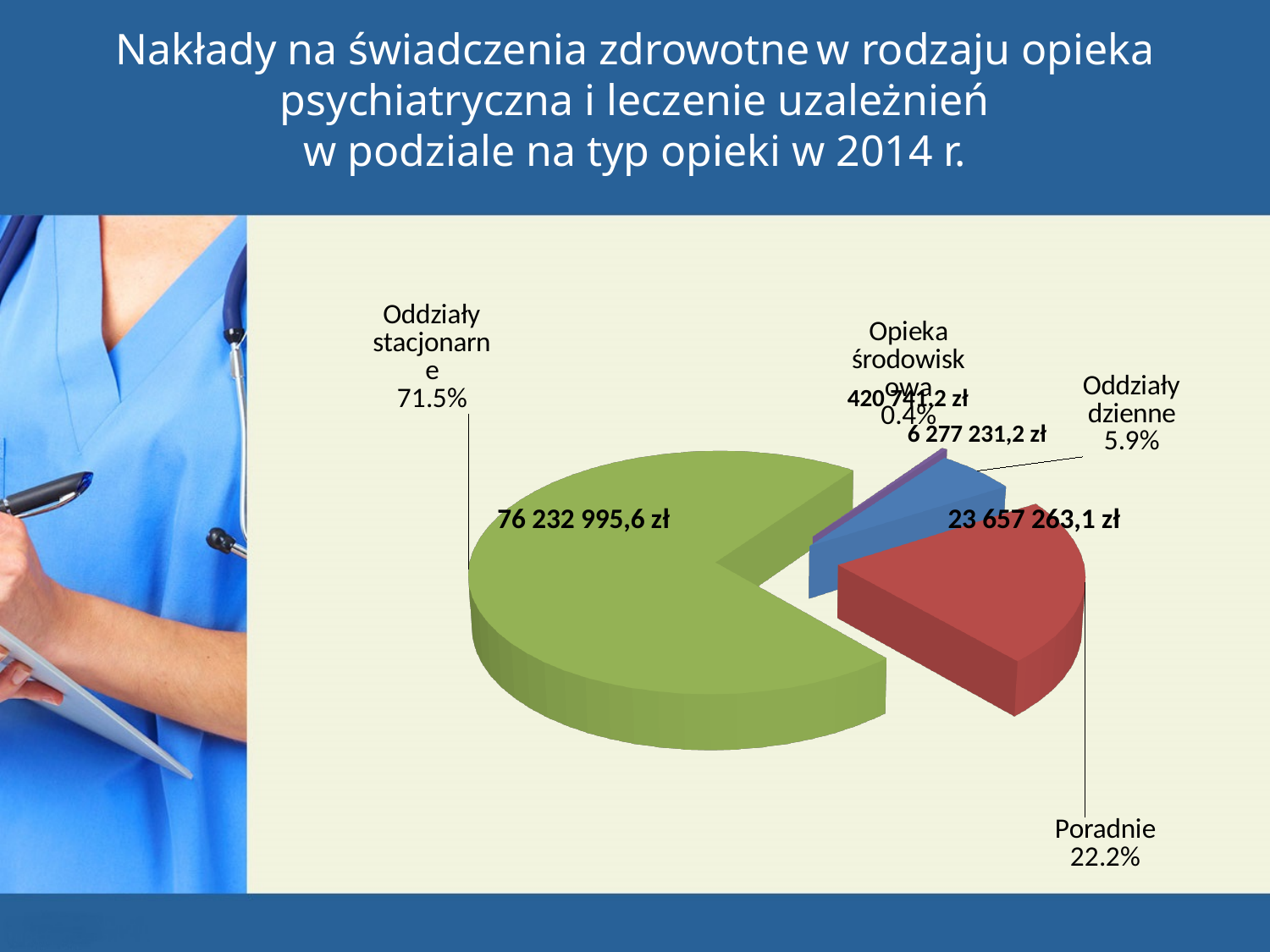
Which category has the largest slice of the pie? Oddziały stacjonarne What share of the pie does Oddziały dzienne represent? 5.9% What is the value shown for Oddziały dzienne? 6 277 231,2 zł What share of the pie does Opieka środowiskowa represent? 0.4% How many slices does the pie chart have? 4 What is the value shown for Oddziały stacjonarne? 76 232 995,6 zł What is the value shown for Poradnie? 23 657 263,1 zł What share of the pie does Poradnie represent? 22.2% Which category has the smallest slice of the pie? Opieka środowiskowa Which is larger, the value for Poradnie or the value for Oddziały dzienne? Poradnie What kind of chart is shown on the slide? pie chart